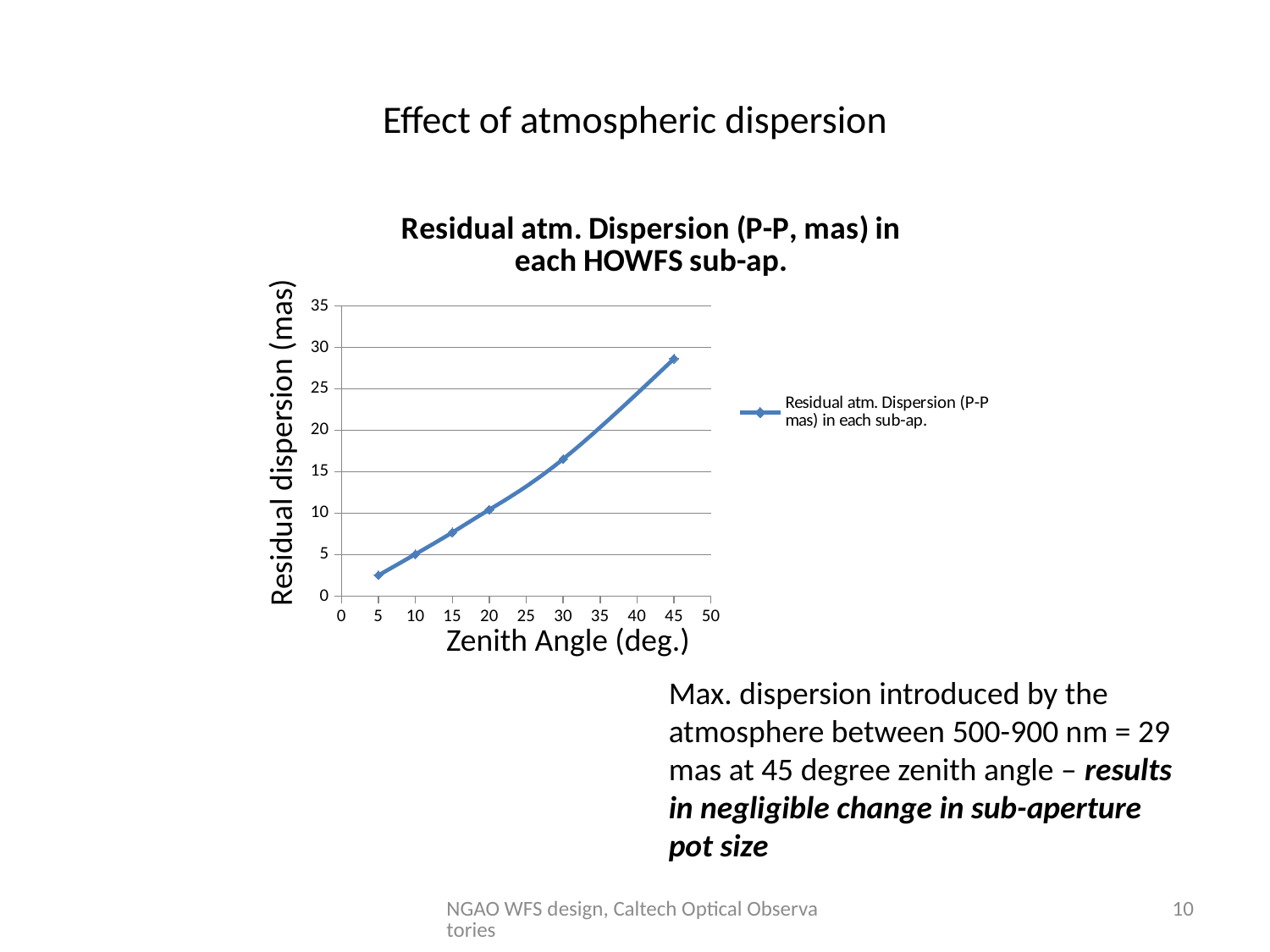
Is the residual dispersion at a zenith angle of 30 degrees greater or less than 20? less Does the residual dispersion rise or fall as the zenith angle increases? rises At which zenith angle is the residual dispersion lowest? 5 How many data points are plotted on the line? 6 What is the label of the x axis? Zenith Angle (deg.) Is the residual dispersion at a zenith angle of 45 degrees greater or less than 25? greater Which has the larger residual dispersion: a zenith angle of 15 degrees or 30 degrees? 30 degrees At which zenith angle is the residual dispersion highest? 45 How many series does the legend list? 1 What kind of chart is shown on the slide? line chart What is the title of the chart? Residual atm. Dispersion (P-P, mas) in each HOWFS sub-ap.